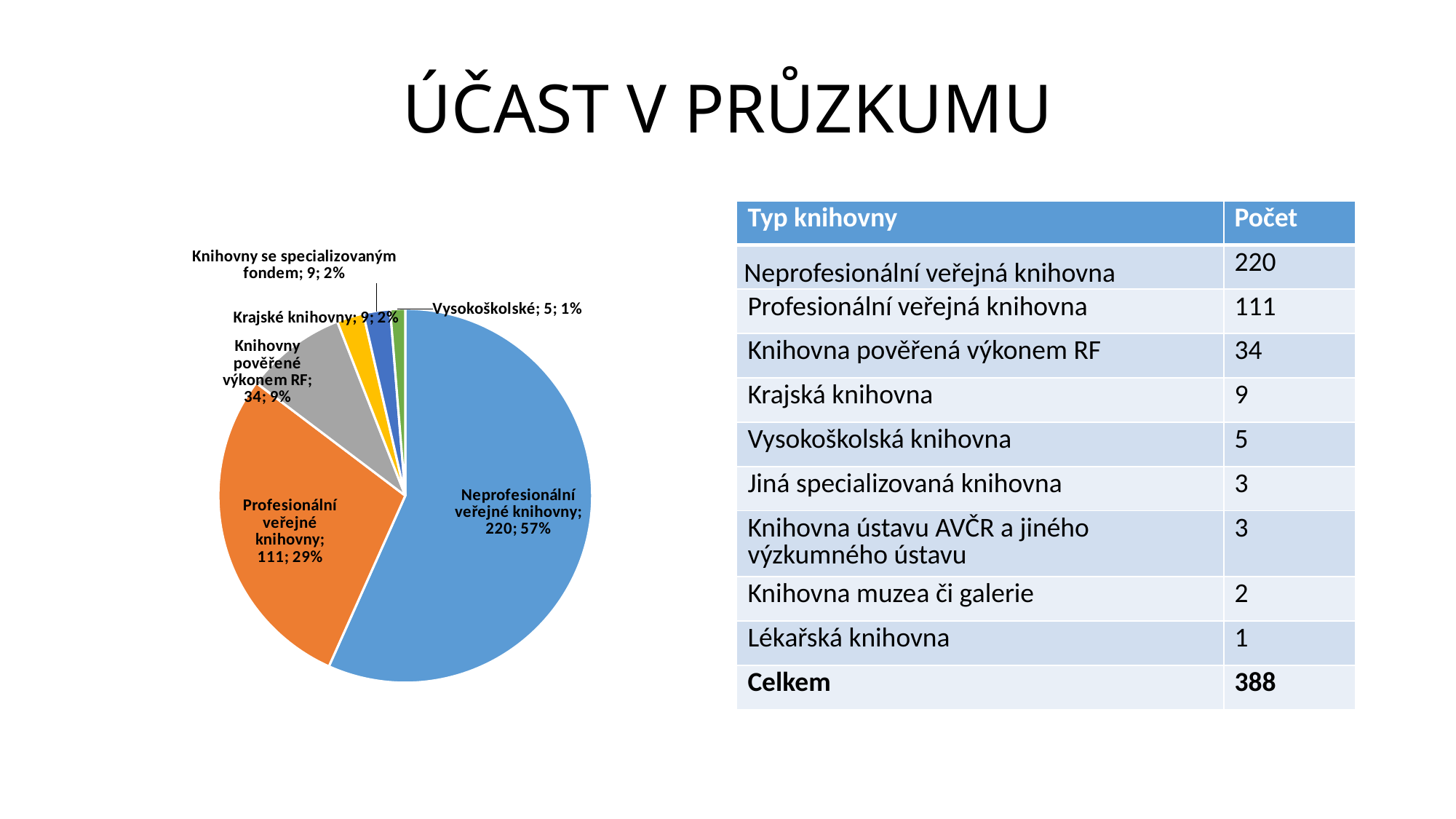
What percentage share does the Vysokoškolské slice have in the pie chart? 1% Which category has the largest slice in the pie chart? Neprofesionální veřejné knihovny How many slices does the pie chart have? 6 What colour is the Profesionální veřejné knihovny slice in the pie chart? orange Which is larger in the pie chart: Knihovny pověřené výkonem RF or Krajské knihovny? Knihovny pověřené výkonem RF What percentage share does the Profesionální veřejné knihovny slice have in the pie chart? 29% What is the difference between the values for Neprofesionální veřejné knihovny and Profesionální veřejné knihovny in the pie chart? 109 Which category has the smallest slice in the pie chart? Vysokoškolské What value is shown for Knihovny se specializovaným fondem in the pie chart? 9 What value is shown for Knihovny pověřené výkonem RF in the pie chart? 34 What value is shown for Neprofesionální veřejné knihovny in the pie chart? 220 What kind of chart is shown on the slide? pie chart